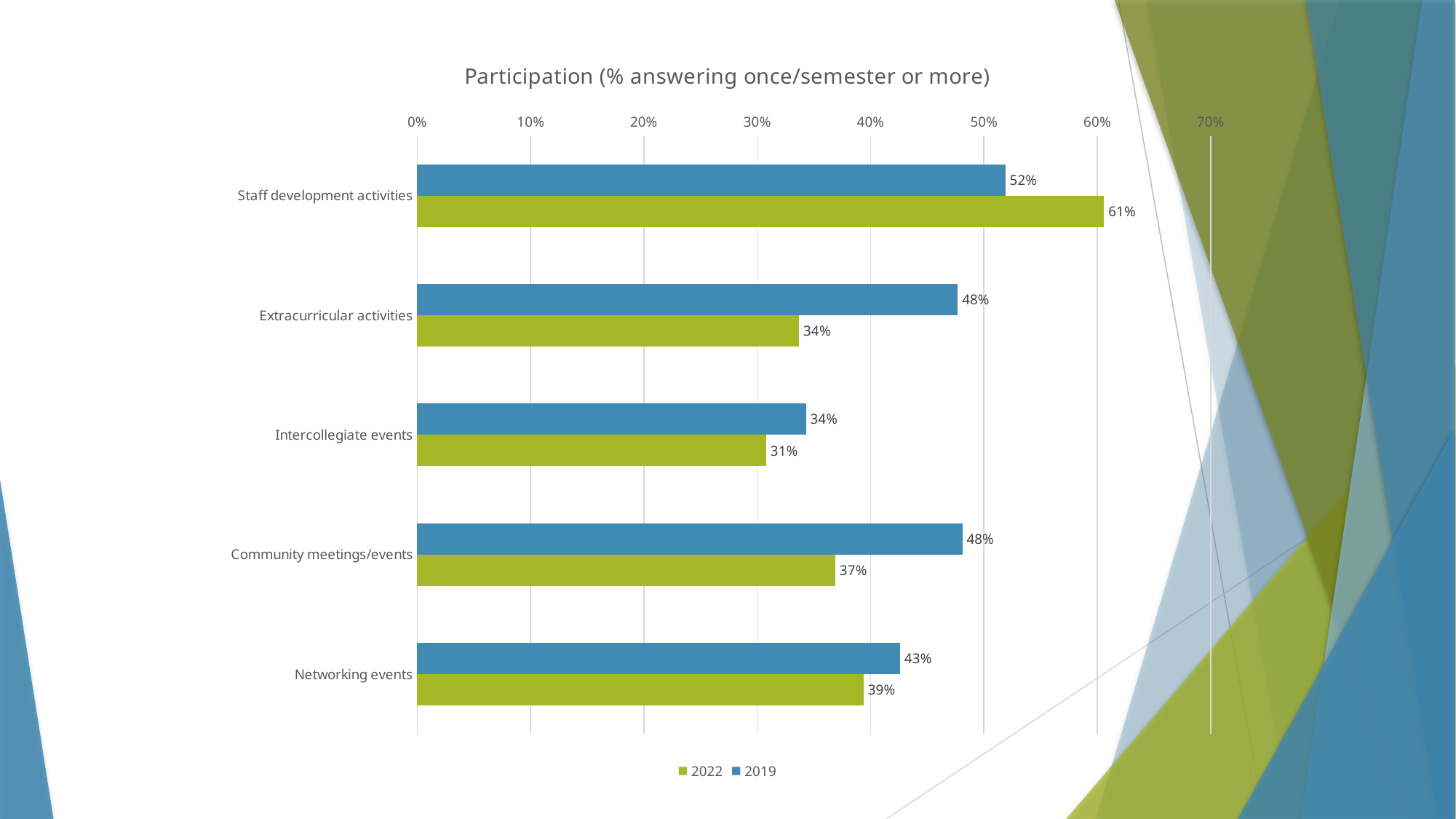
Which colour represents the 2022 series? Green What kind of chart is shown on the slide? Bar chart How many categories are shown on the chart? 5 Which category has the highest 2019 value? Staff development activities What is the 2022 value for Networking events? 39% What is the 2022 value for Staff development activities? 61% What is the title of the chart? Participation (% answering once/semester or more) How many series does the legend list? 2 Which category has the lowest 2022 value? Intercollegiate events What is the difference between the 2019 and 2022 values for Extracurricular activities? 14% What is the 2019 value for Extracurricular activities? 48% Which is larger for Community meetings/events, the 2019 value or the 2022 value? 2019